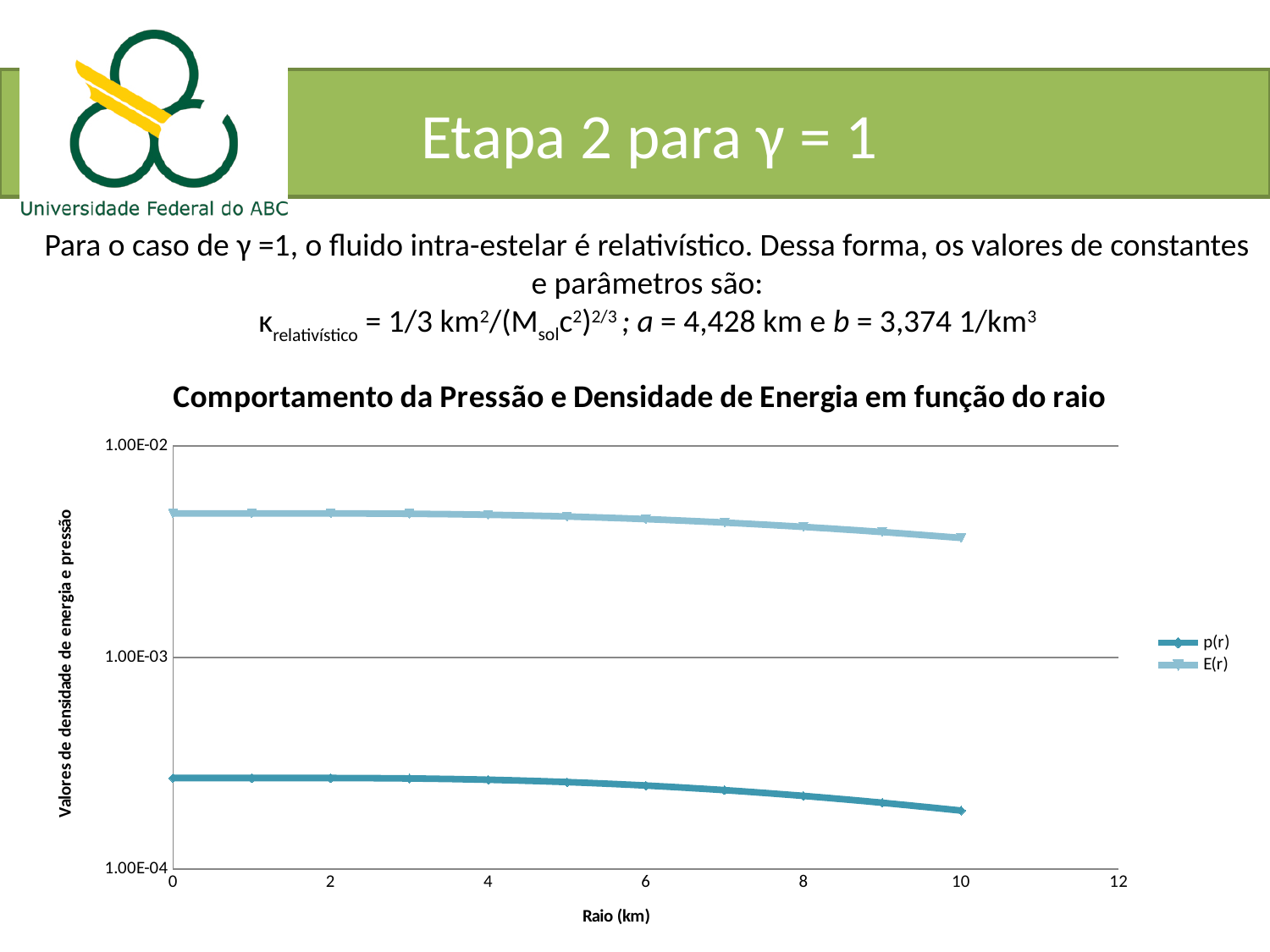
What are the two series named in the chart legend? p(r) and E(r) Is the value of E(r) at radius 10 km greater or less than 1.00E-03? greater Is the value of p(r) at radius 0 km greater or less than 1.00E-03? less Does the E(r) series rise or fall as the radius increases along the x axis? fall Is the value of E(r) at radius 0 km greater or less than 1.00E-02? less Which series has the larger value at radius 0 km, p(r) or E(r)? E(r) Does the p(r) series rise or fall as the radius increases along the x axis? fall What kind of chart is shown on the slide? line chart How many series does the chart legend list? 2 How many data points are plotted for the p(r) series? 11 At which radius does the E(r) series reach its lowest value? 10 What is the title of the chart? Comportamento da Pressão e Densidade de Energia em função do raio